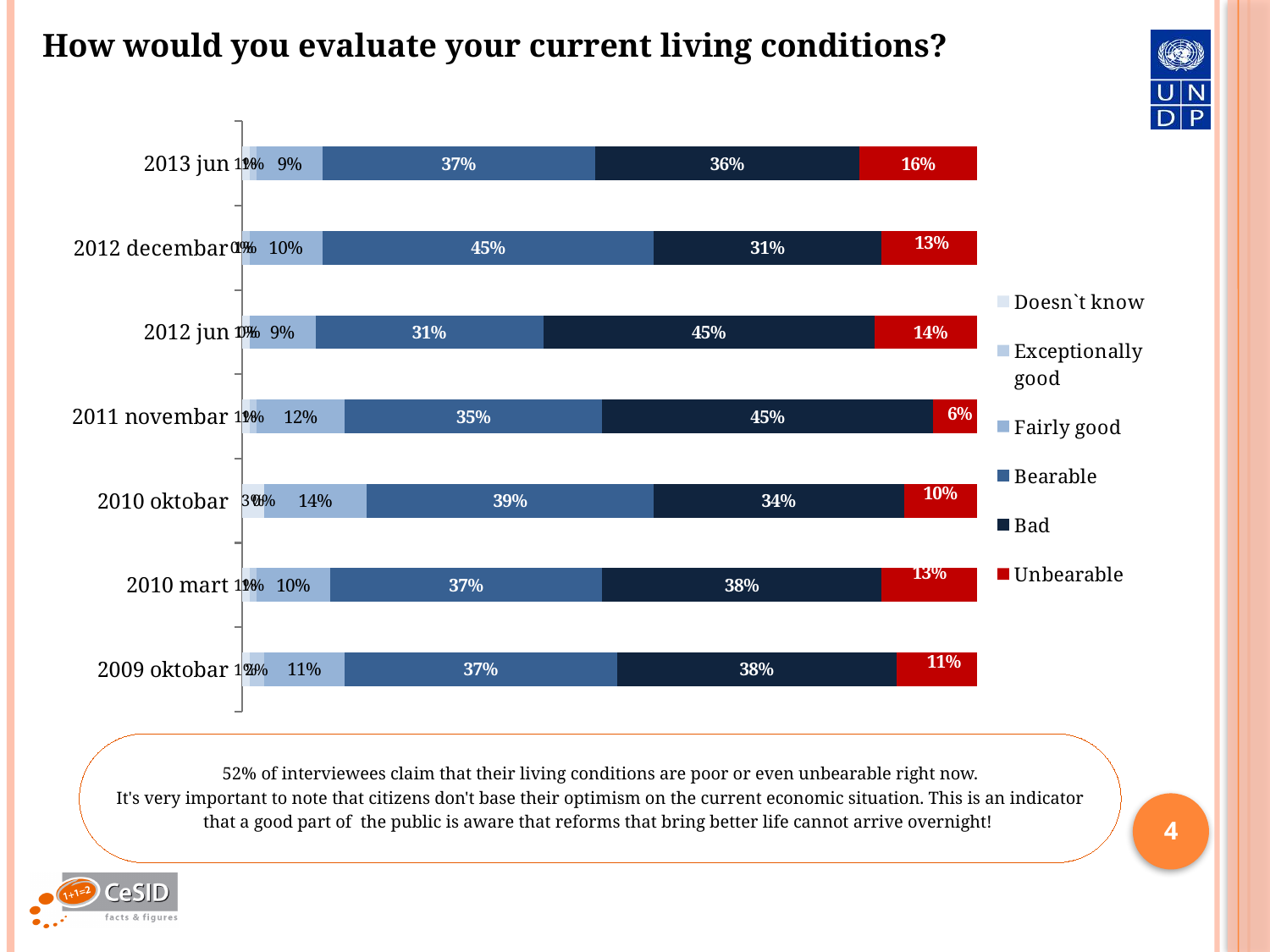
Which is larger for 2013 jun: the Bearable value or the Bad value? Bearable Which time period has the lowest Unbearable value? 2011 novembar What is the title of the chart? How would you evaluate your current living conditions? How many series does the legend list? 6 What is the Bearable value for 2012 decembar? 45% How many time periods (categories) are shown on the chart? 7 What is the Unbearable value for 2013 jun? 16% Which time period has the highest Unbearable value? 2013 jun What is the Fairly good value for 2010 oktobar? 14% What kind of chart is shown on the slide? Stacked bar chart What is the Bad value for 2012 jun? 45% What is the difference between the Bad value for 2012 jun and the Bad value for 2012 decembar? 14%